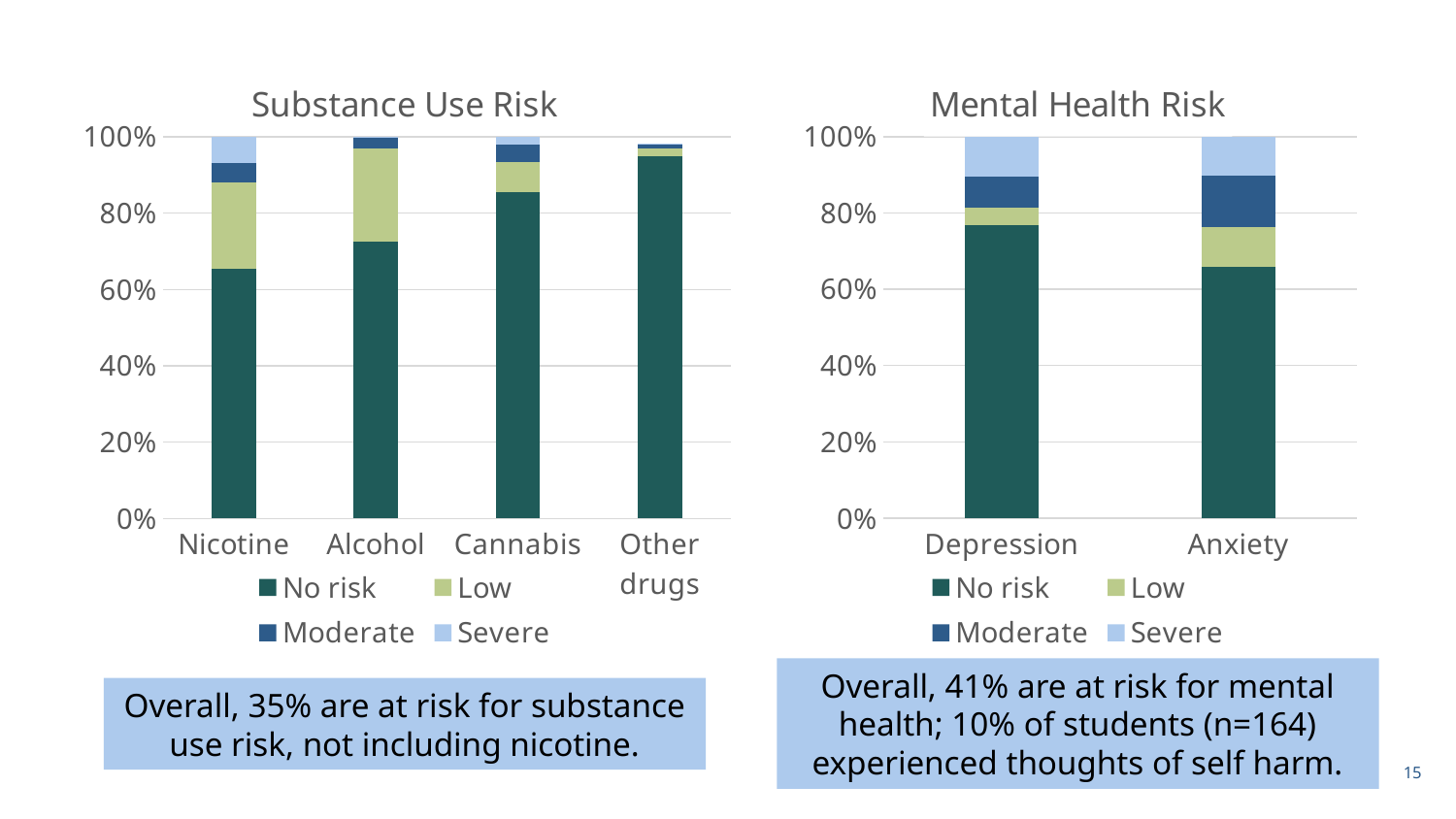
What kind of chart is the Substance Use Risk chart? stacked bar chart How many series does the legend of the Mental Health Risk chart list? 4 In the Substance Use Risk chart, is the No risk value for Nicotine greater or less than 80%? less In the Substance Use Risk chart, which category has the largest No risk segment? Other drugs In the Substance Use Risk chart, which category has the smallest No risk segment? Nicotine How many categories are shown on the x axis of the Mental Health Risk chart? 2 How many categories are shown on the x axis of the Substance Use Risk chart? 4 In the Mental Health Risk chart, is the No risk value for Anxiety greater or less than 60%? greater What is the title of the chart on the right side of the slide? Mental Health Risk In the Mental Health Risk chart, which category has the larger No risk segment, Depression or Anxiety? Depression In the Substance Use Risk chart, what is the total height of the Nicotine stacked bar? 100% In the Substance Use Risk chart, is the No risk value for Other drugs greater or less than 80%? greater